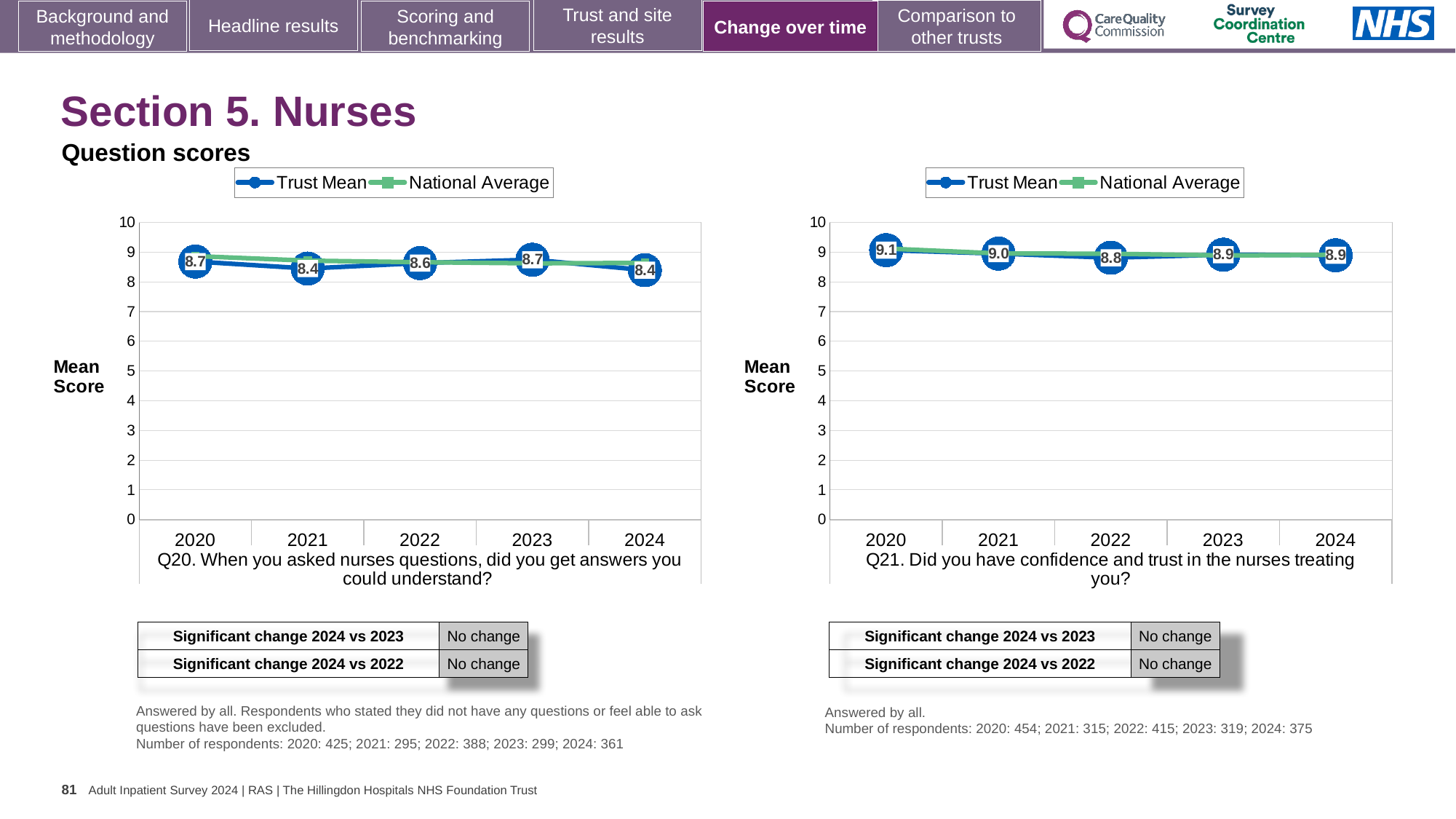
How many years are plotted on the x axis of the Q20 chart? 5 How many series does the legend of the Q21 chart list? 2 What kind of chart is the Q20 chart? Line chart In the Q20 chart, which is larger, the Trust Mean for 2021 or for 2022? 2022 In the Q21 chart, which year has the lowest Trust Mean score? 2022 In the Q20 chart, what is the Trust Mean score for 2024? 8.4 In the Q21 chart, which year has the highest Trust Mean score? 2020 In the Q21 chart, is the National Average value for 2024 greater or less than 8? greater In the Q20 chart, what is the difference between the Trust Mean scores for 2023 and 2024? 0.3 In the Q21 chart, what is the Trust Mean score for 2020? 9.1 In the Q21 chart, what is the difference between the Trust Mean scores for 2020 and 2022? 0.3 In the Q20 chart, what is the Trust Mean score for 2022? 8.6